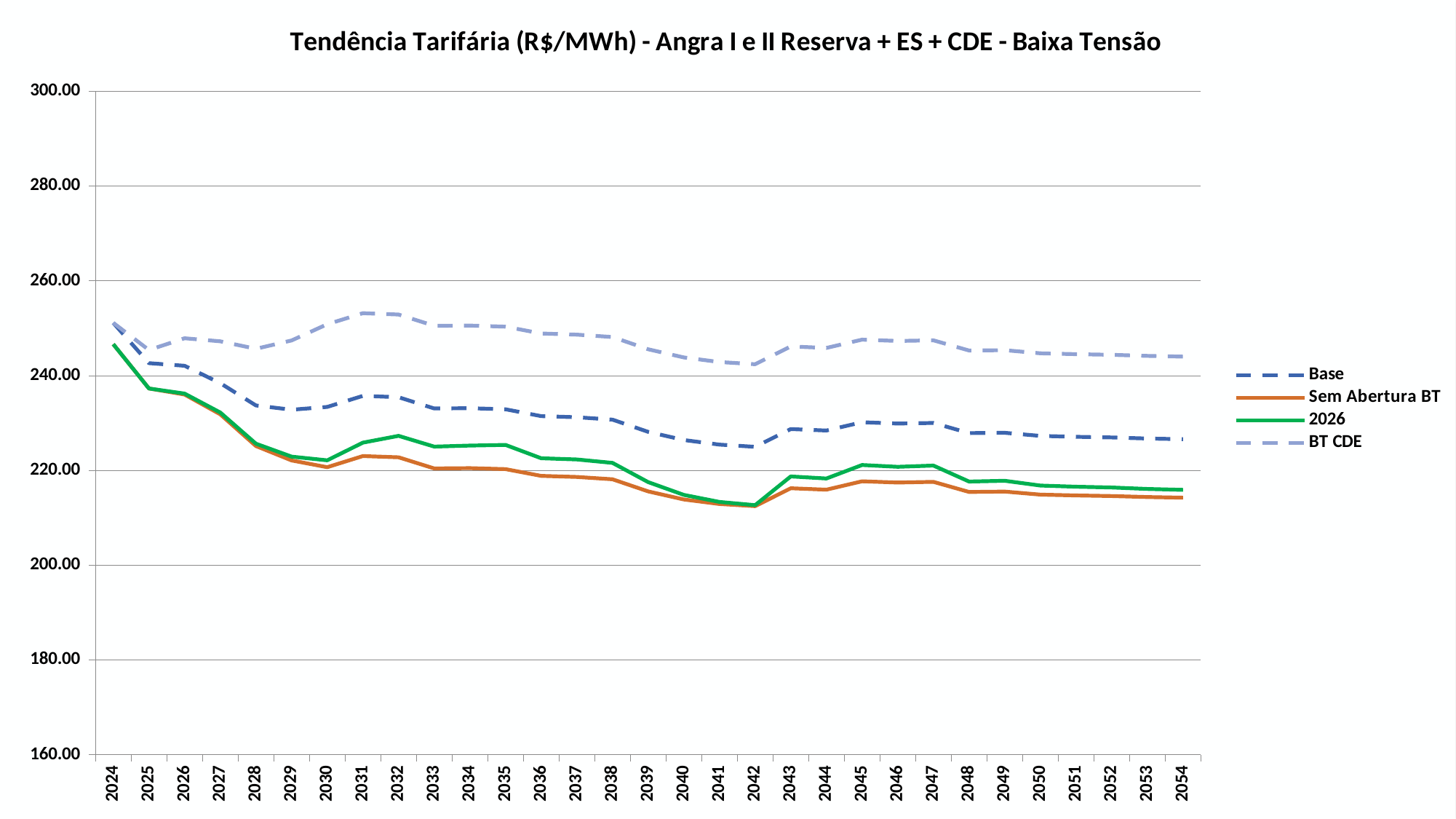
How many series does the legend list? 4 Is the Base value for 2054 greater or less than 220.00? greater In 2040, which is larger, the Base value or the Sem Abertura BT value? Base What kind of chart is shown on the slide? line chart Which series is drawn as a solid green line? 2026 Is the BT CDE value for 2031 greater or less than 240.00? greater Is the Sem Abertura BT value for 2042 greater or less than 220.00? less Which series has the highest value in 2050? BT CDE Which series has the lowest value in 2054? Sem Abertura BT What is the title of the chart? Tendência Tarifária (R$/MWh) - Angra I e II Reserva + ES + CDE - Baixa Tensão Does the Base series rise or fall from 2024 to 2054? fall How many years are plotted along the x axis? 31